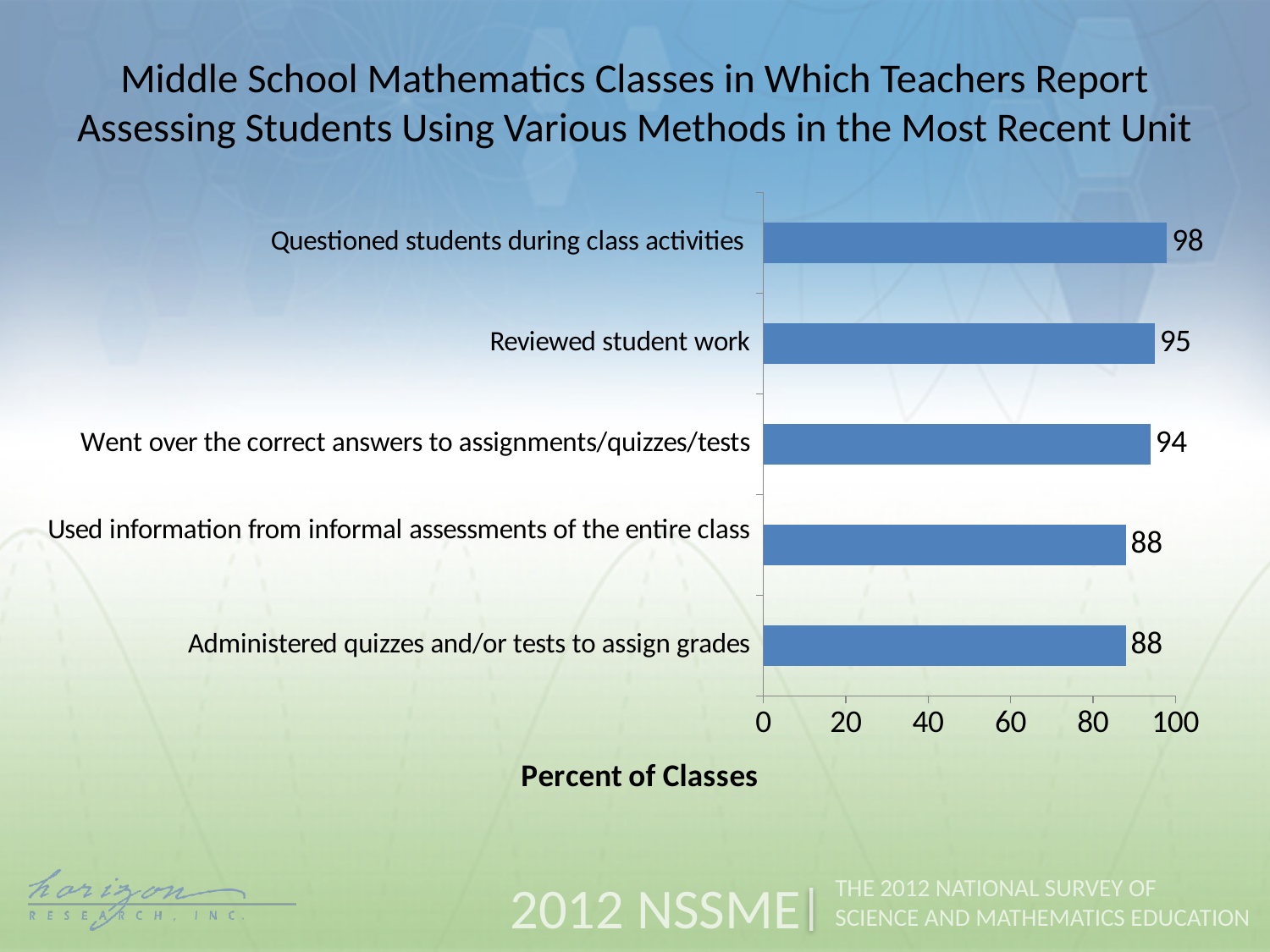
What is the value for 'Administered quizzes and/or tests to assign grades'? 88 Which assessment method has the highest percent of classes? Questioned students during class activities Is the value for 'Used information from informal assessments of the entire class' greater or less than 80? greater What is the label of the horizontal axis? Percent of Classes What percent of classes reported 'Questioned students during class activities'? 98 What is the value for 'Reviewed student work'? 95 Which is larger: the value for 'Reviewed student work' or the value for 'Administered quizzes and/or tests to assign grades'? Reviewed student work What is the value for 'Went over the correct answers to assignments/quizzes/tests'? 94 What kind of chart is shown on the slide? Bar chart What is the difference between 'Reviewed student work' and 'Went over the correct answers to assignments/quizzes/tests'? 1 What is the difference between 'Questioned students during class activities' and 'Used information from informal assessments of the entire class'? 10 How many assessment methods are shown in the chart? 5